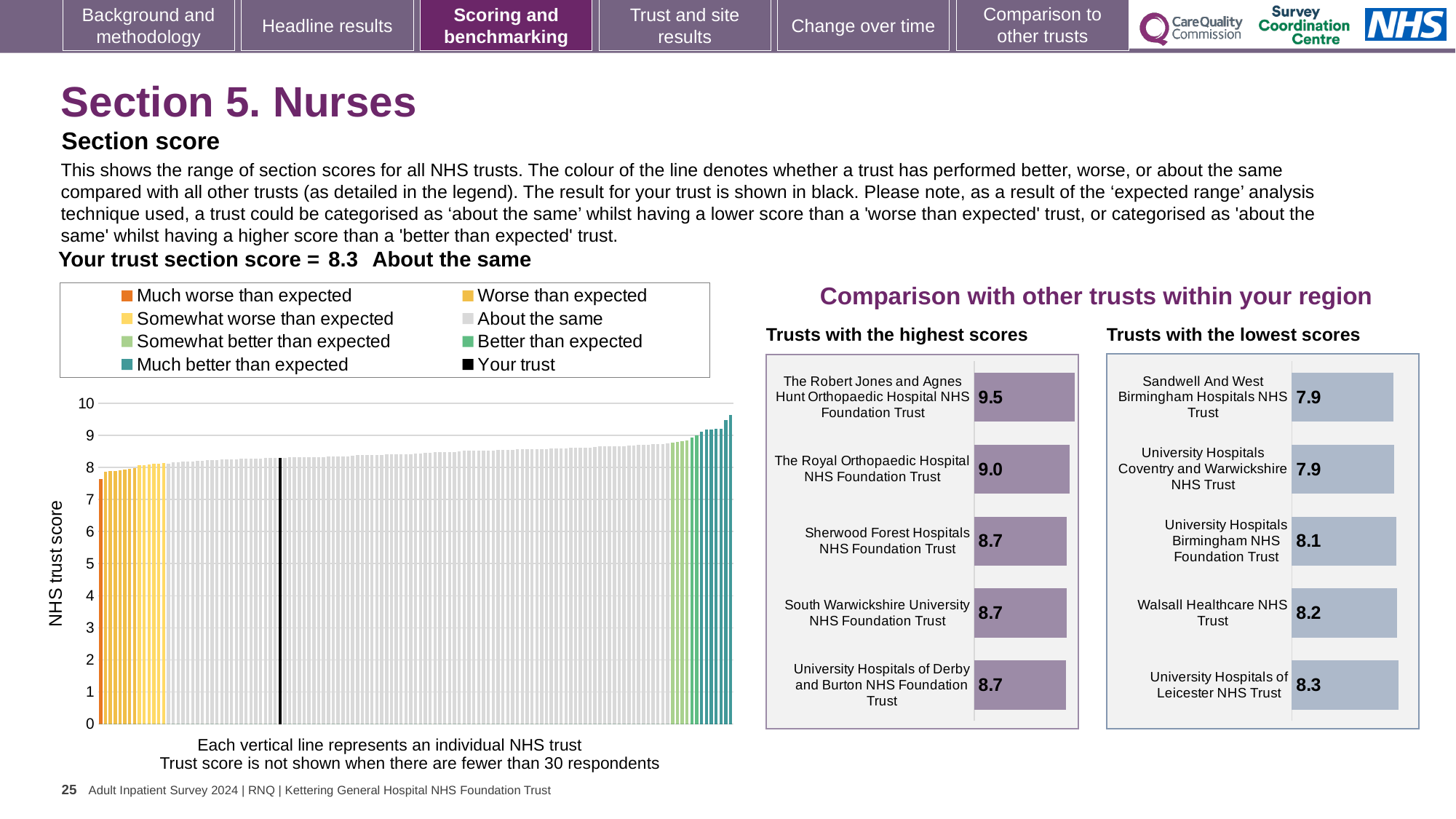
In the 'Trusts with the highest scores' chart, how many trusts are listed? 5 How many entries does the legend of the large chart on the left list? 8 In the 'Trusts with the lowest scores' chart, what is the difference between the scores of University Hospitals of Leicester NHS Trust and Walsall Healthcare NHS Trust? 0.1 What kind of chart is the large chart on the left showing the range of NHS trust scores? Bar chart In the 'Trusts with the highest scores' chart, what is the score for The Robert Jones and Agnes Hunt Orthopaedic Hospital NHS Foundation Trust? 9.5 In the 'Trusts with the lowest scores' chart, which is larger: the score for University Hospitals Birmingham NHS Foundation Trust or Walsall Healthcare NHS Trust? Walsall Healthcare NHS Trust In the 'Trusts with the lowest scores' chart, what is the score for Walsall Healthcare NHS Trust? 8.2 In the 'Trusts with the lowest scores' chart, which trust has the highest score? University Hospitals of Leicester NHS Trust In the 'Trusts with the highest scores' chart, what is the score for The Royal Orthopaedic Hospital NHS Foundation Trust? 9.0 In the 'Trusts with the lowest scores' chart, what is the score for Sandwell And West Birmingham Hospitals NHS Trust? 7.9 In the large chart on the left, do the trust scores rise or fall from left to right? Rise In the 'Trusts with the highest scores' chart, what is the difference between the scores of The Robert Jones and Agnes Hunt Orthopaedic Hospital NHS Foundation Trust and The Royal Orthopaedic Hospital NHS Foundation Trust? 0.5